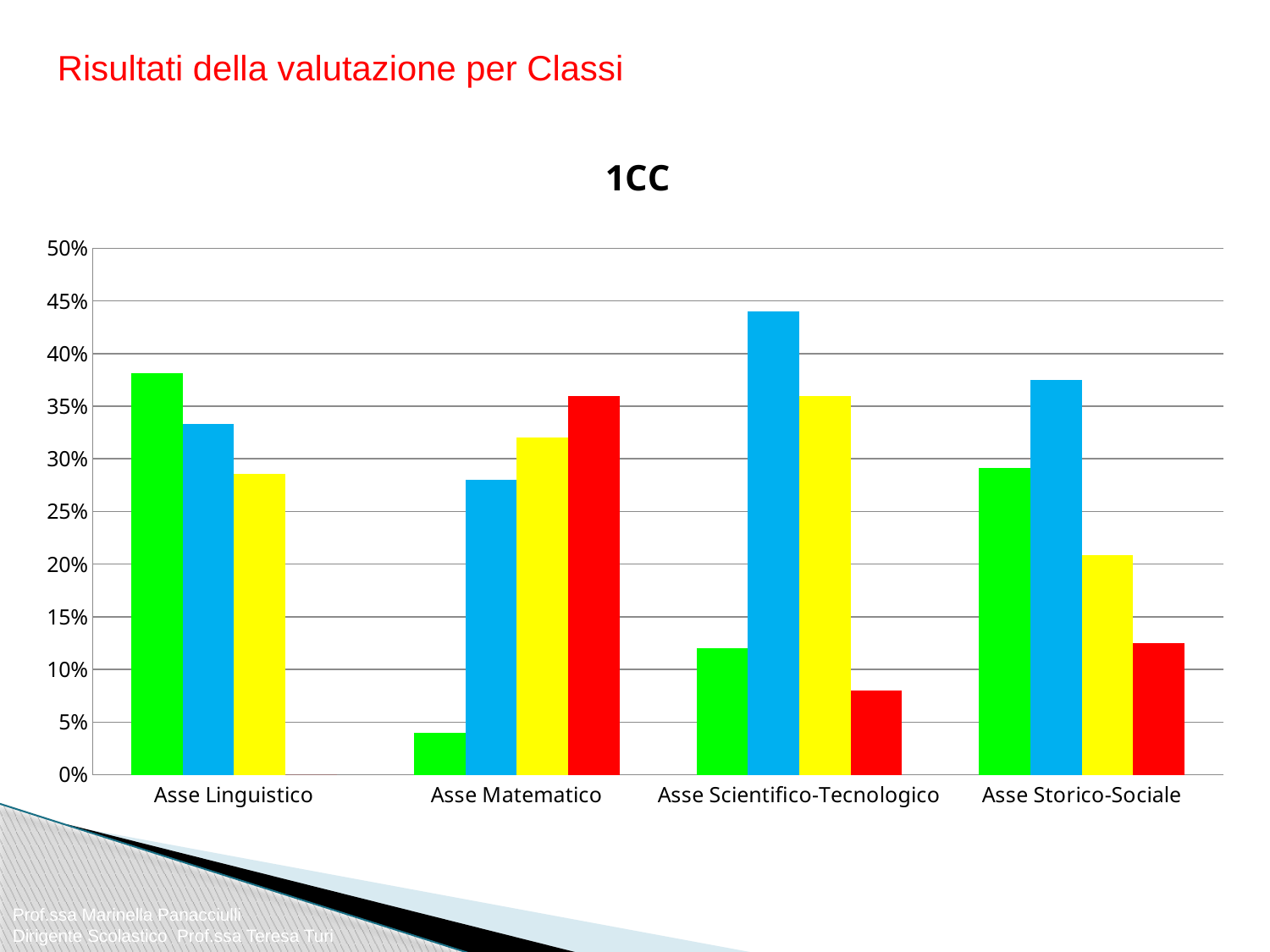
Which coloured bar is the tallest in the Asse Matematico category? red How many bars are plotted for the Asse Linguistico category? 3 Is the value of the green bar for Asse Linguistico greater or less than 35%? greater Which is larger: the blue bar for Asse Scientifico-Tecnologico or the blue bar for Asse Storico-Sociale? Asse Scientifico-Tecnologico Which category contains the tallest bar in the chart? Asse Scientifico-Tecnologico Which coloured bar is the shortest in the Asse Matematico category? green What is the title of the chart? 1CC Is the value of the blue bar for Asse Scientifico-Tecnologico greater or less than 40%? greater How many categories are shown on the x axis of the chart? 4 What kind of chart is shown on the slide? bar chart Is the value of the green bar for Asse Matematico greater or less than 10%? less